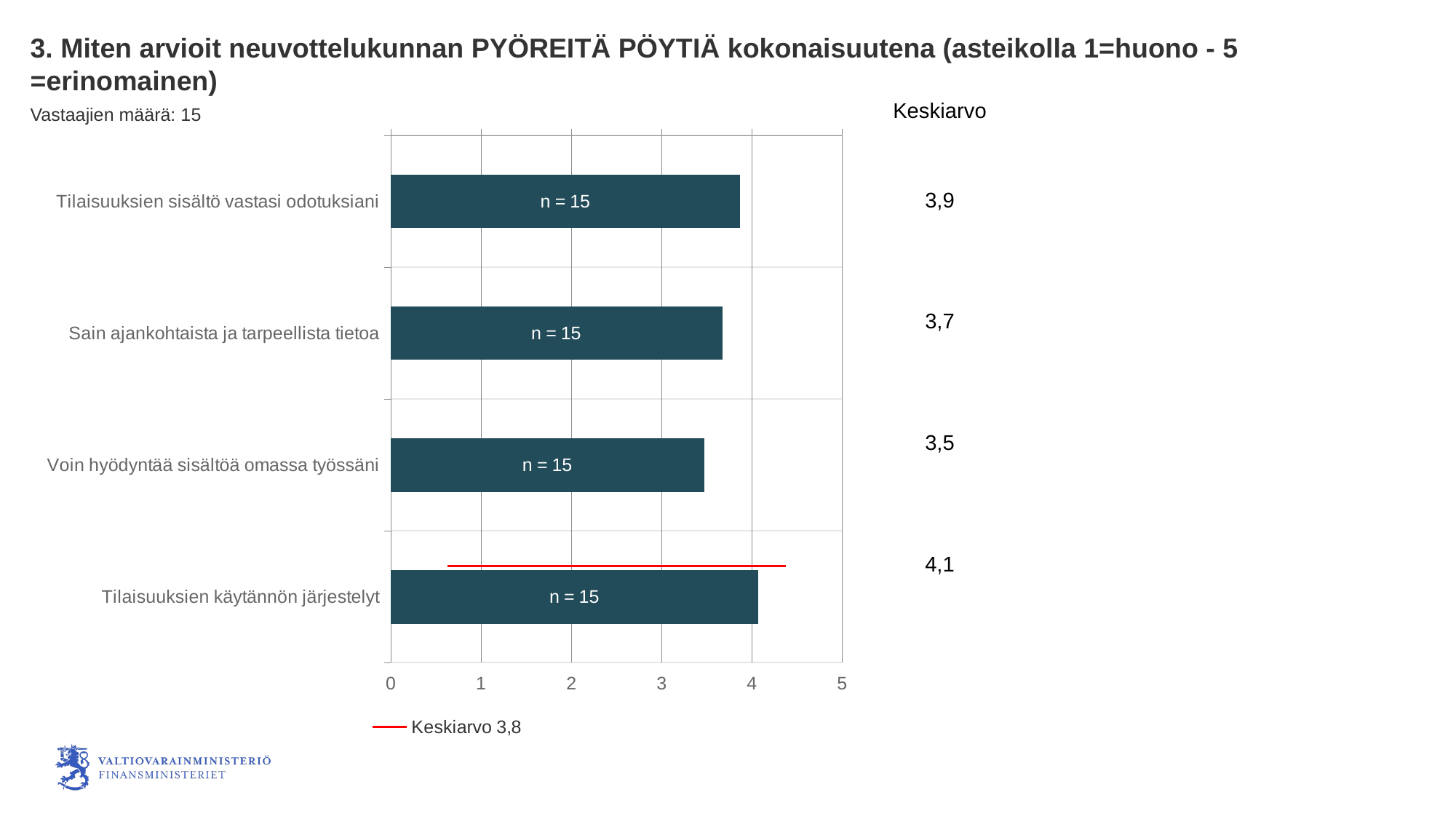
What is the average (Keskiarvo) for "Sain ajankohtaista ja tarpeellista tietoa"? 3,7 What is the average (Keskiarvo) for "Tilaisuuksien käytännön järjestelyt"? 4,1 How many categories are shown in the chart? 4 Which category has the lowest average? Voin hyödyntää sisältöä omassa työssäni Is the value for "Voin hyödyntää sisältöä omassa työssäni" greater or less than 4? less Which has a higher average: "Tilaisuuksien sisältö vastasi odotuksiani" or "Sain ajankohtaista ja tarpeellista tietoa"? Tilaisuuksien sisältö vastasi odotuksiani What is the difference between the averages for "Tilaisuuksien käytännön järjestelyt" and "Voin hyödyntää sisältöä omassa työssäni"? 0,6 Which category has the highest average? Tilaisuuksien käytännön järjestelyt What overall average (Keskiarvo) does the red line in the legend represent? 3,8 What is the average (Keskiarvo) for "Tilaisuuksien sisältö vastasi odotuksiani"? 3,9 What is the average (Keskiarvo) for "Voin hyödyntää sisältöä omassa työssäni"? 3,5 What kind of chart is shown on the slide? Bar chart